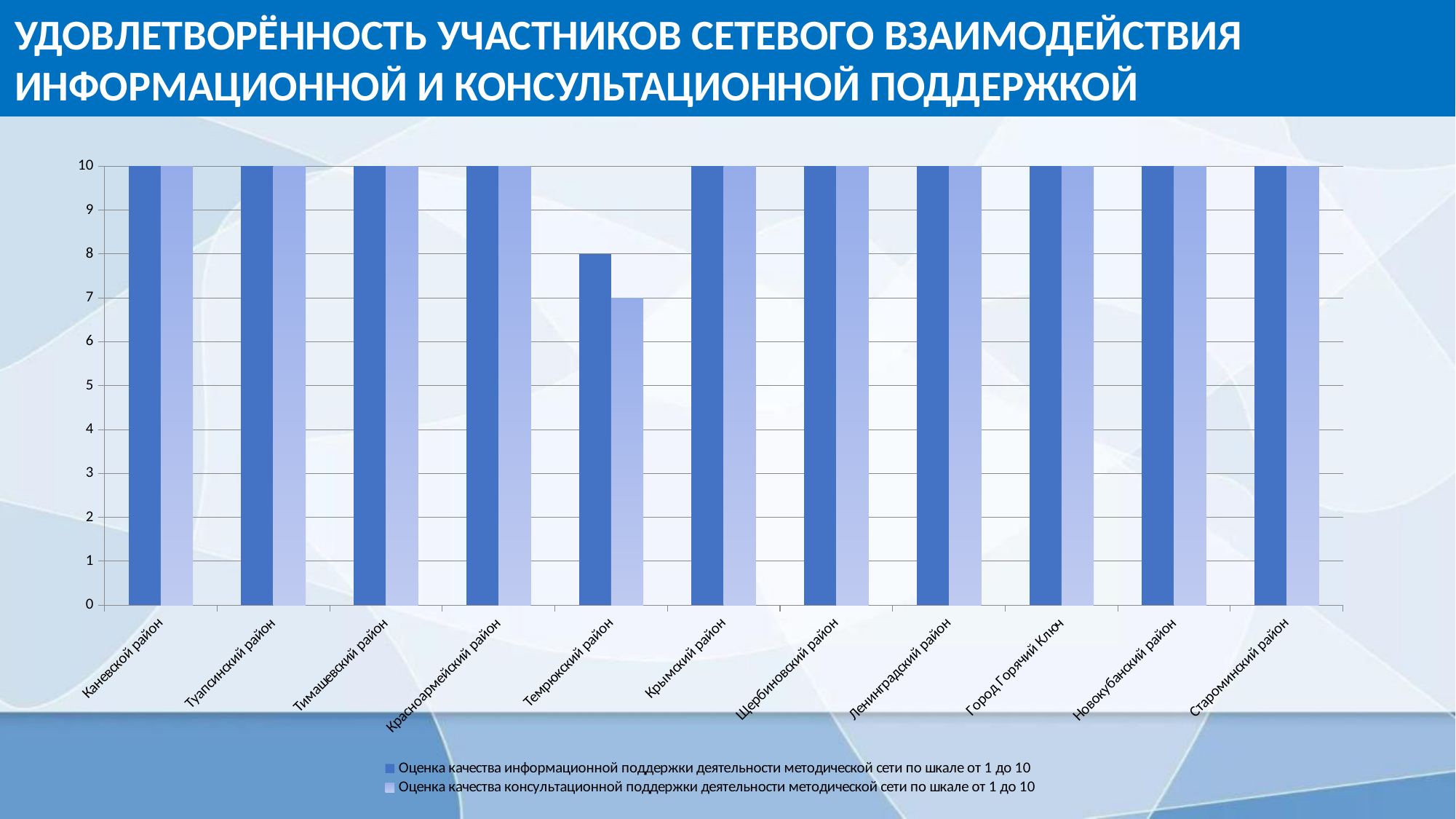
What is the value of 'Оценка качества информационной поддержки' for Каневской район? 10 For Темрюкский район, which is larger: the information support score or the consultation support score? information support score What is the maximum value shown on the vertical axis of the chart? 10 What is the value of 'Оценка качества информационной поддержки' for Темрюкский район? 8 How many series does the chart legend list? 2 What kind of chart is shown on the slide? bar chart Is the value of 'Оценка качества консультационной поддержки' for Темрюкский район greater or less than 9? less Which district has the lowest value for 'Оценка качества консультационной поддержки'? Темрюкский район How many districts (categories) are shown on the x axis of the chart? 11 What is the value of 'Оценка качества консультационной поддержки' for Староминский район? 10 What is the value of 'Оценка качества консультационной поддержки' for Темрюкский район? 7 What is the difference between the information support score and the consultation support score for Темрюкский район? 1